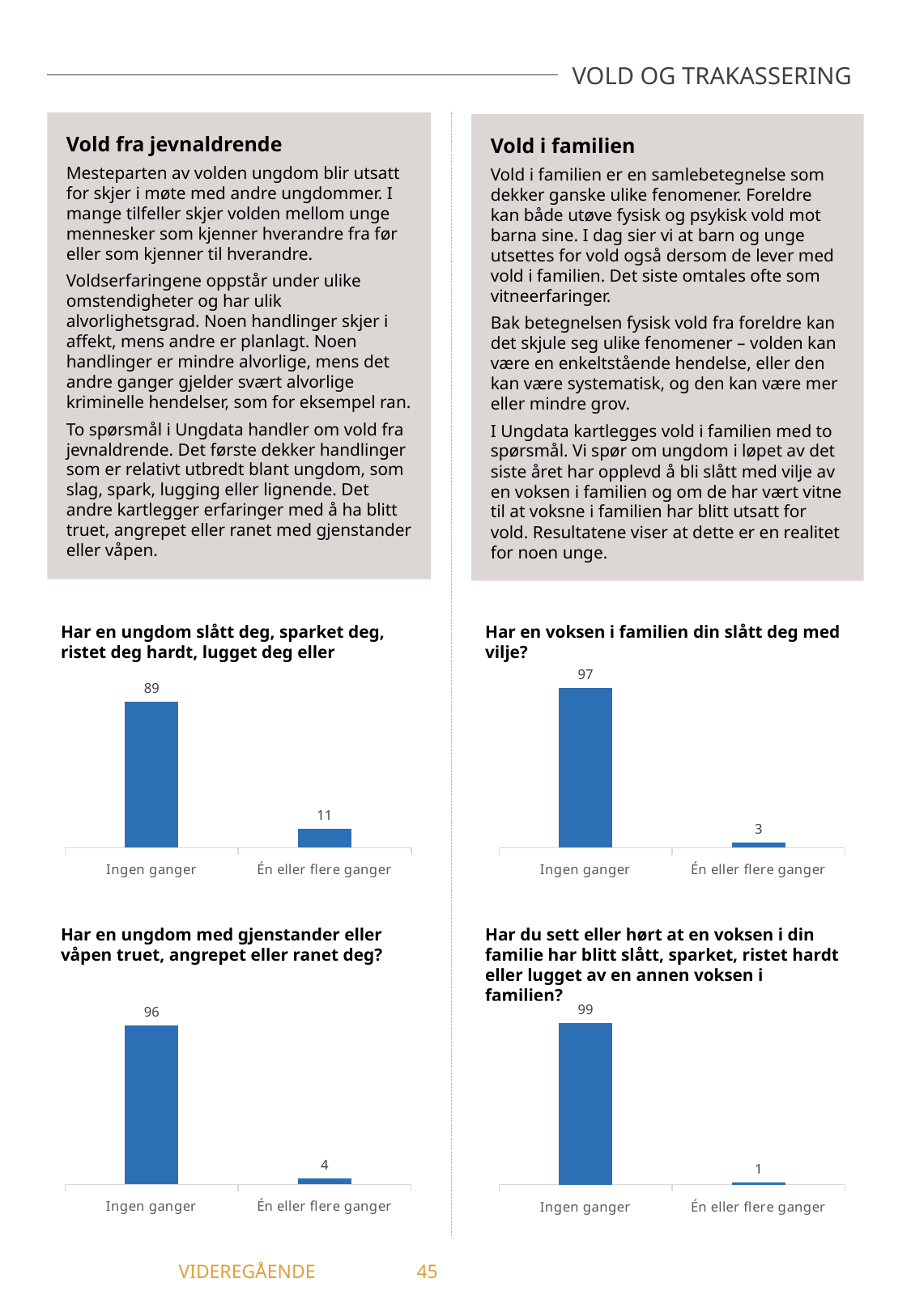
In the bottom-left chart ("Har en ungdom med gjenstander eller våpen truet, angrepet eller ranet deg?"), which category has the highest value? Ingen ganger In the bottom-right chart ("Har du sett eller hørt at en voksen i din familie har blitt slått..."), what is the value for "Ingen ganger"? 99 In the top-right chart ("Har en voksen i familien din slått deg med vilje?"), what is the value for "Ingen ganger"? 97 In the bottom-left chart ("Har en ungdom med gjenstander eller våpen truet, angrepet eller ranet deg?"), what is the value for "Én eller flere ganger"? 4 In the bottom-right chart ("Har du sett eller hørt at en voksen i din familie har blitt slått..."), which category has the lowest value? Én eller flere ganger In the bottom-left chart ("Har en ungdom med gjenstander eller våpen truet, angrepet eller ranet deg?"), what is the difference between "Ingen ganger" and "Én eller flere ganger"? 92 What kind of chart is the bottom-right chart ("Har du sett eller hørt at en voksen i din familie har blitt slått...")? Bar chart In the top-left chart ("Har en ungdom slått deg, sparket deg..."), what is the value for "Én eller flere ganger"? 11 In the top-left chart ("Har en ungdom slått deg, sparket deg..."), what is the difference between "Ingen ganger" and "Én eller flere ganger"? 78 In the top-right chart ("Har en voksen i familien din slått deg med vilje?"), what is the value for "Én eller flere ganger"? 3 How many categories does the top-right chart ("Har en voksen i familien din slått deg med vilje?") show? 2 In the top-left chart ("Har en ungdom slått deg, sparket deg, ristet deg hardt, lugget deg eller"), what is the value for "Ingen ganger"? 89